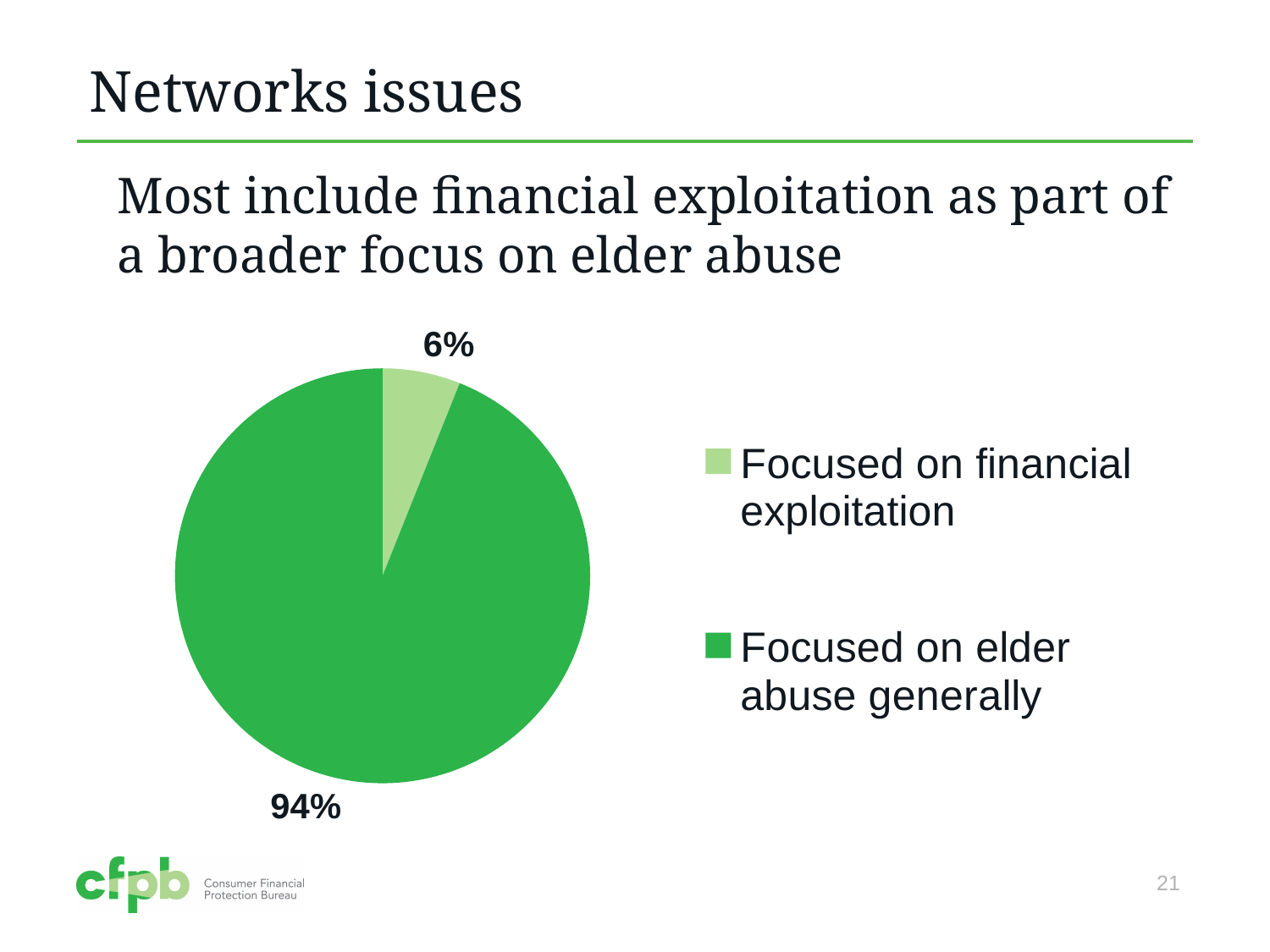
How many slices does the pie chart have? 2 What is the title of the slide containing the pie chart? Networks issues What is the difference in percentage points between the 'Focused on elder abuse generally' slice and the 'Focused on financial exploitation' slice? 88 How many entries does the legend list? 2 Which slice of the pie is the smallest? Focused on financial exploitation Which legend entry is shown in the lighter green colour? Focused on financial exploitation Which is larger: the 'Focused on financial exploitation' slice or the 'Focused on elder abuse generally' slice? Focused on elder abuse generally Which slice of the pie is the largest? Focused on elder abuse generally What share of the pie is labelled 'Focused on elder abuse generally'? 94% What kind of chart is shown on the slide? pie chart What share of the pie is labelled 'Focused on financial exploitation'? 6%